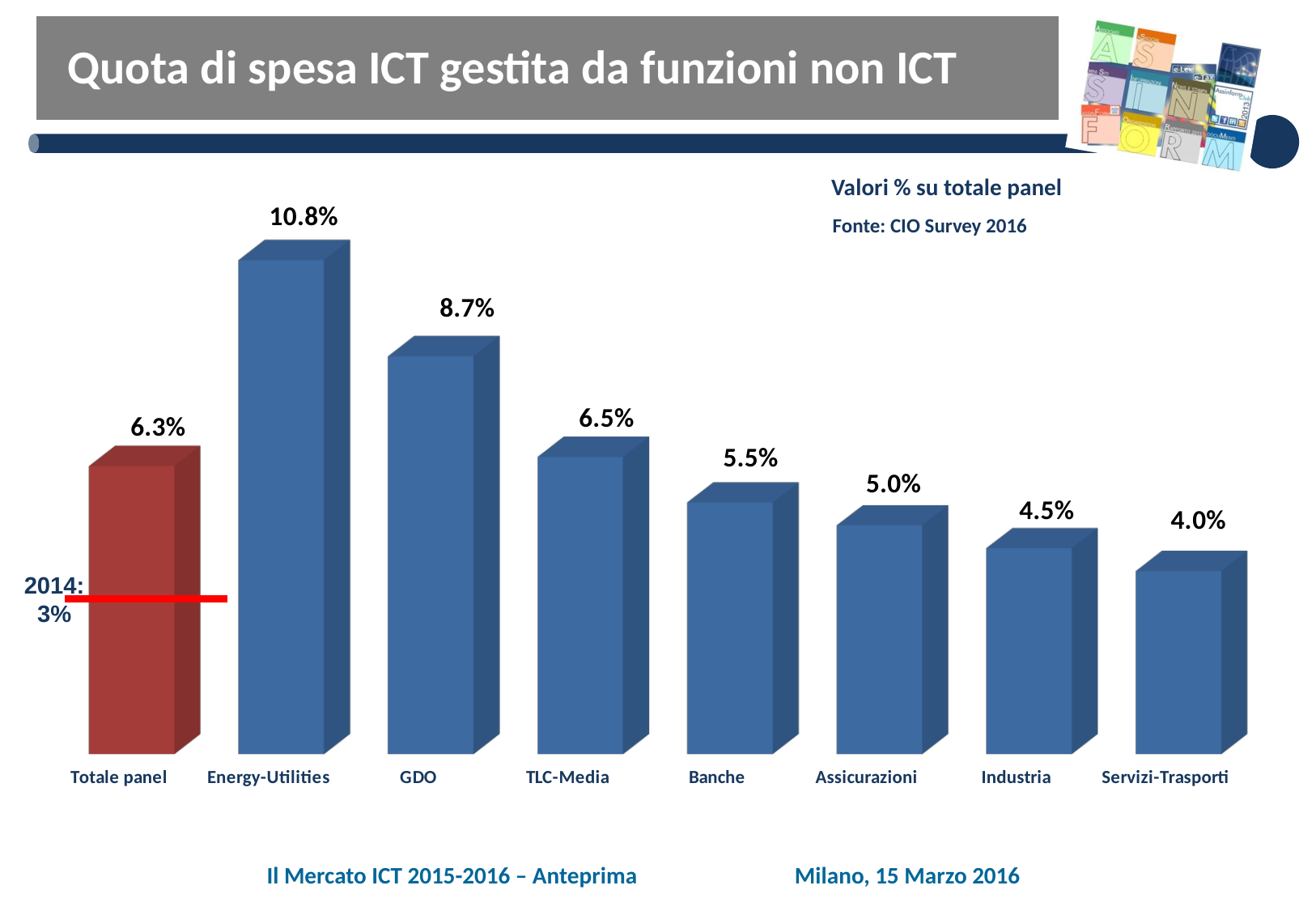
Which category has the lowest value? Servizi-Trasporti What kind of chart is shown on the slide? Bar chart How many categories are shown in the chart? 8 Which is larger, the value for GDO or the value for TLC-Media? GDO What is the difference between the values for TLC-Media and Industria? 2.0% What is the difference between the values for Energy-Utilities and GDO? 2.1% What is the source cited for the chart? CIO Survey 2016 Which category has the highest value? Energy-Utilities What is the value for Banche? 5.5% What is the value for Totale panel? 6.3% What is the value for Energy-Utilities? 10.8% What value is indicated for 2014 by the red line on the Totale panel bar? 3%